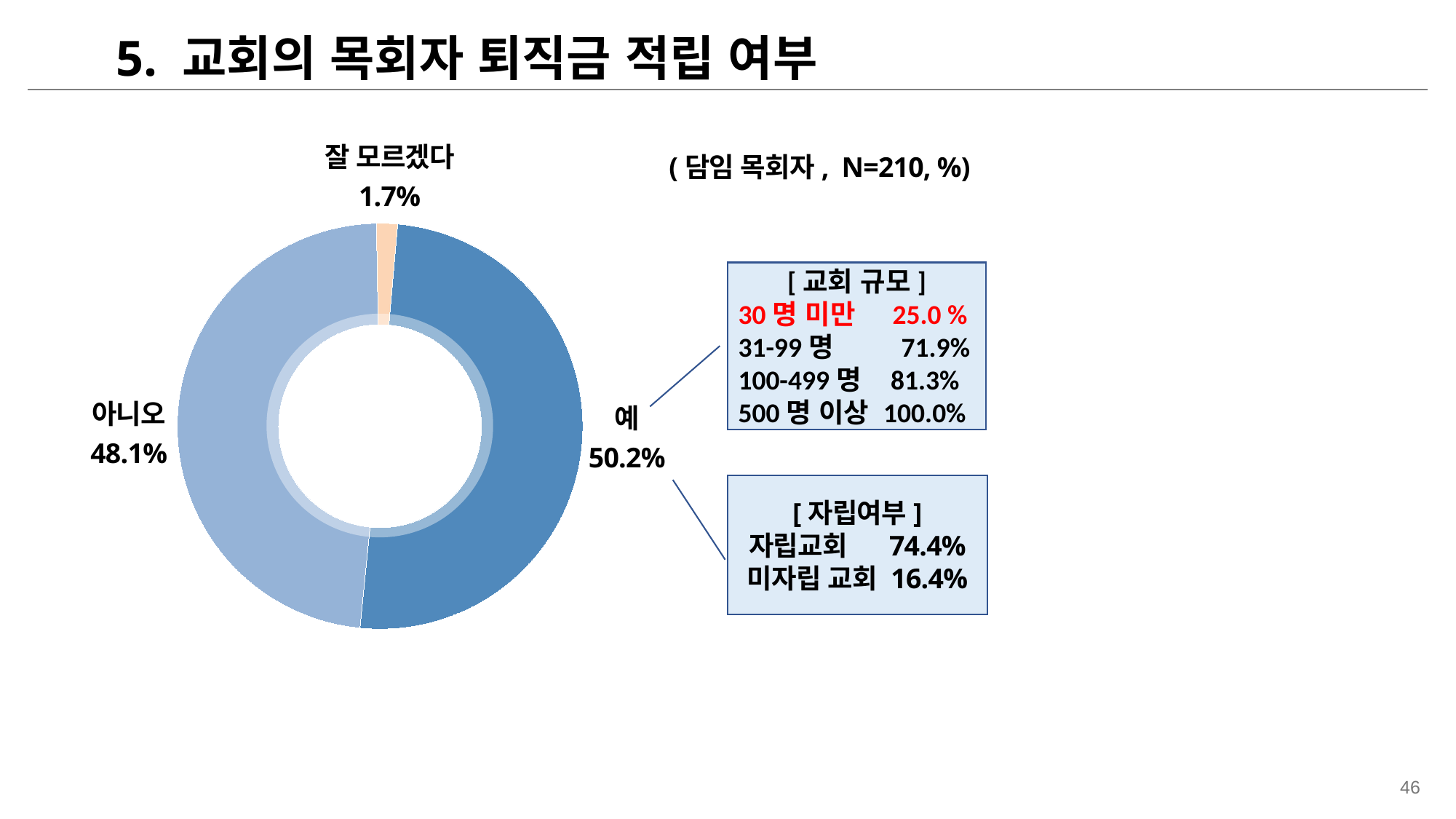
Which response category has the largest share in the donut chart? 예 What is the sample size (N) stated on the slide? 210 According to the [자립여부] box, what percentage is shown for 미자립 교회? 16.4% Which slice is larger, 아니오 or 잘 모르겠다? 아니오 What type of chart is shown on the slide? Donut (pie) chart Which response category has the smallest share in the donut chart? 잘 모르겠다 According to the [교회 규모] box, what percentage is shown for 500 명 이상? 100.0% How many response categories are shown in the donut chart? 3 What is the difference in percentage points between the 예 and 아니오 slices? 2.1 percentage points What percentage of respondents answered 아니오 (no) in the donut chart? 48.1% What percentage of respondents answered 예 (yes) in the donut chart? 50.2% What percentage of respondents answered 잘 모르겠다 in the donut chart? 1.7%